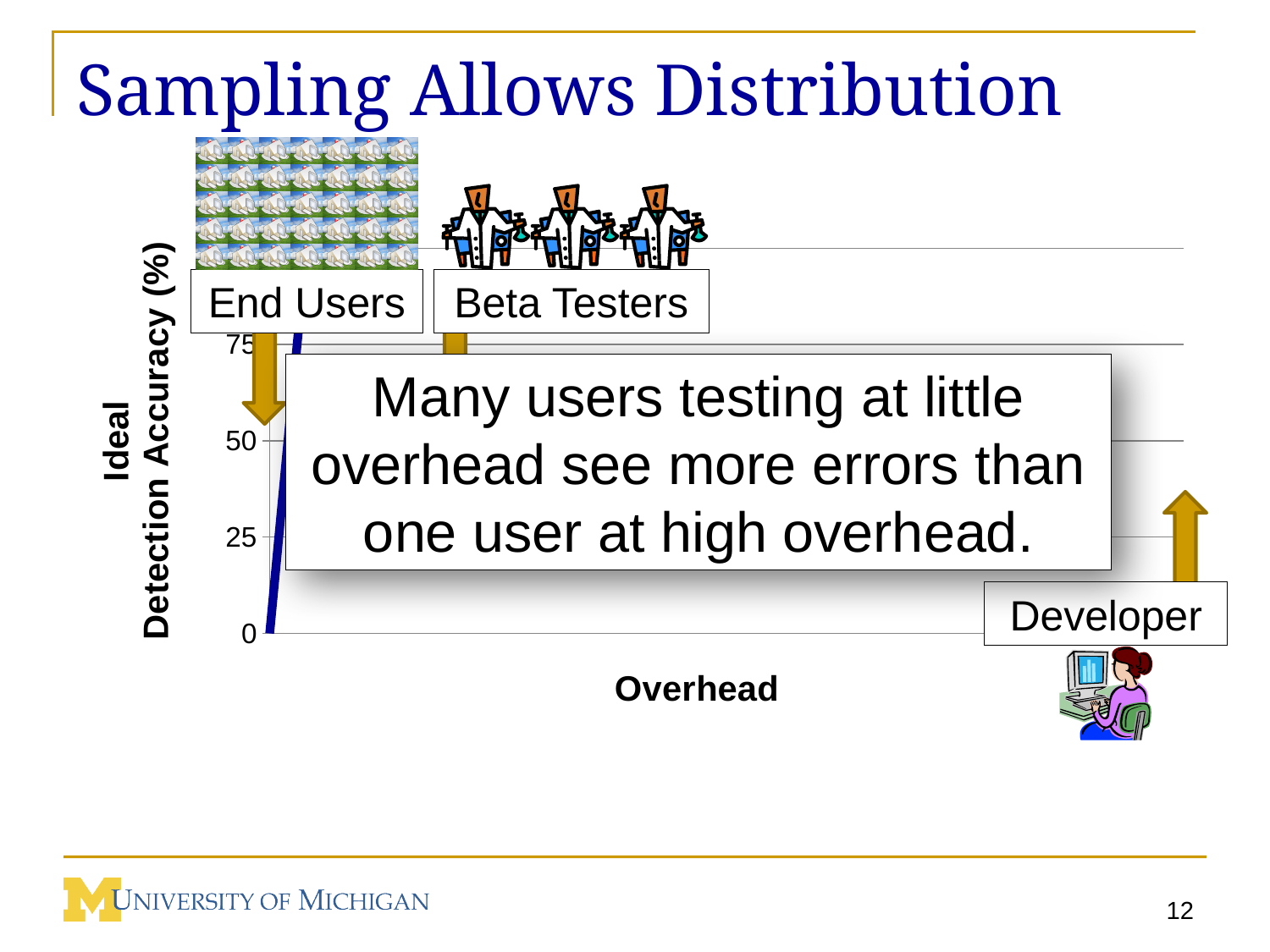
What is the highest tick value readable on the vertical axis? 75 Does the plotted line rise or fall as overhead increases along the x axis? rise What is the label of the vertical axis of the chart? Ideal Detection Accuracy (%) How many user groups are labelled on the chart (End Users, Beta Testers, Developer)? 3 What kind of chart is shown on the slide? line chart Which labelled group is placed at the lowest overhead on the chart? End Users What is the label of the horizontal axis of the chart? Overhead What is the lowest tick value shown on the vertical axis? 0 Which labelled group is placed at the highest overhead on the chart? Developer